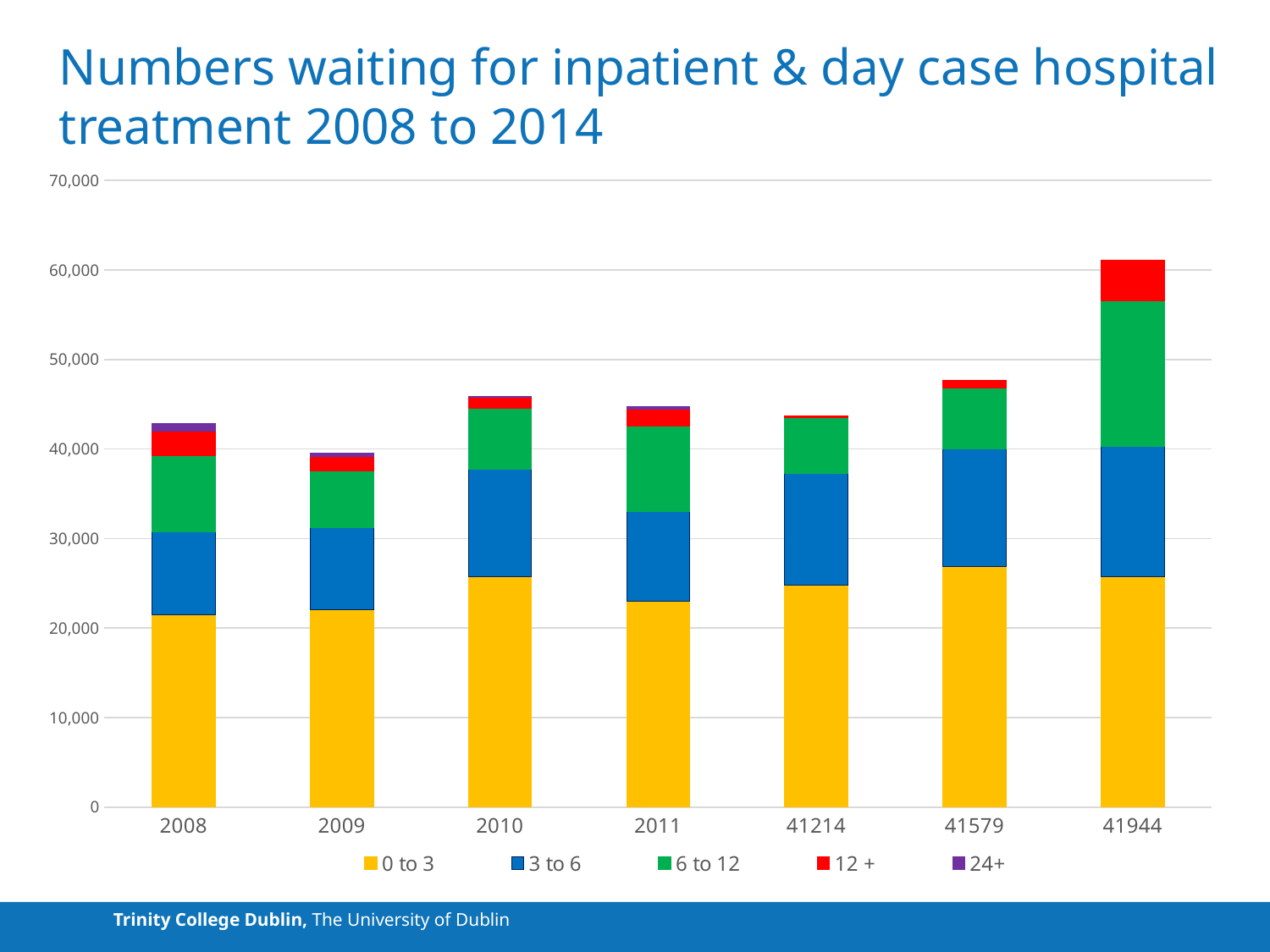
Is the total stacked bar for 2008 greater or less than 40,000? greater Is the total stacked bar for 2010 greater or less than 50,000? less Is the total stacked bar for 41944 greater or less than 50,000? greater What kind of chart is shown on the slide? Stacked bar chart How many series does the legend list? 5 What is the title of the chart? Numbers waiting for inpatient & day case hospital treatment 2008 to 2014 How many categories are shown along the x axis? 7 Which category has the tallest stacked bar? 41944 Which colour represents the '6 to 12' series in the legend? Green Which has the taller stacked bar, 2010 or 2009? 2010 Which category has the shortest stacked bar? 2009